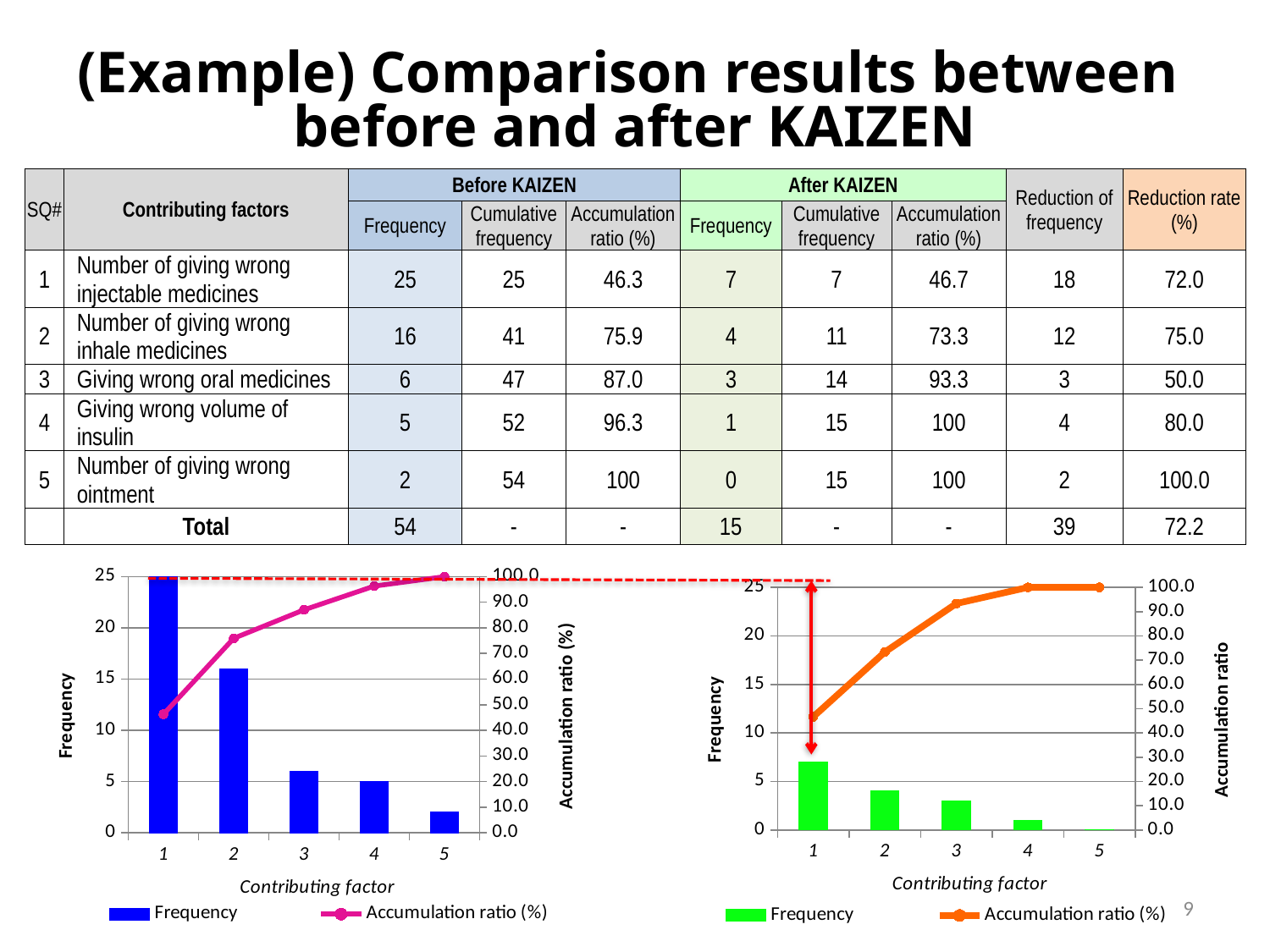
How many contributing factors are plotted on the x axis of the right chart? 5 In the left chart, what is the Frequency for contributing factor 4? 5 What kind of chart is the left chart on the slide? Combined bar and line chart How many series does the legend of the left chart list? 2 In the left chart, what is the difference in Frequency between contributing factor 1 and contributing factor 4? 20 In the right chart, is the Frequency for contributing factor 1 greater or less than 10? less In the right chart, what is the Accumulation ratio at contributing factor 5? 100.0 In the left chart, what is the Frequency for contributing factor 1? 25 In the left chart, which contributing factor has the highest Frequency? 1 In the left chart, is the Accumulation ratio at contributing factor 1 greater or less than 50.0? less In the right chart, does the Frequency rise or fall from contributing factor 1 to contributing factor 5? fall In the right chart, which contributing factor has the lowest Frequency? 5